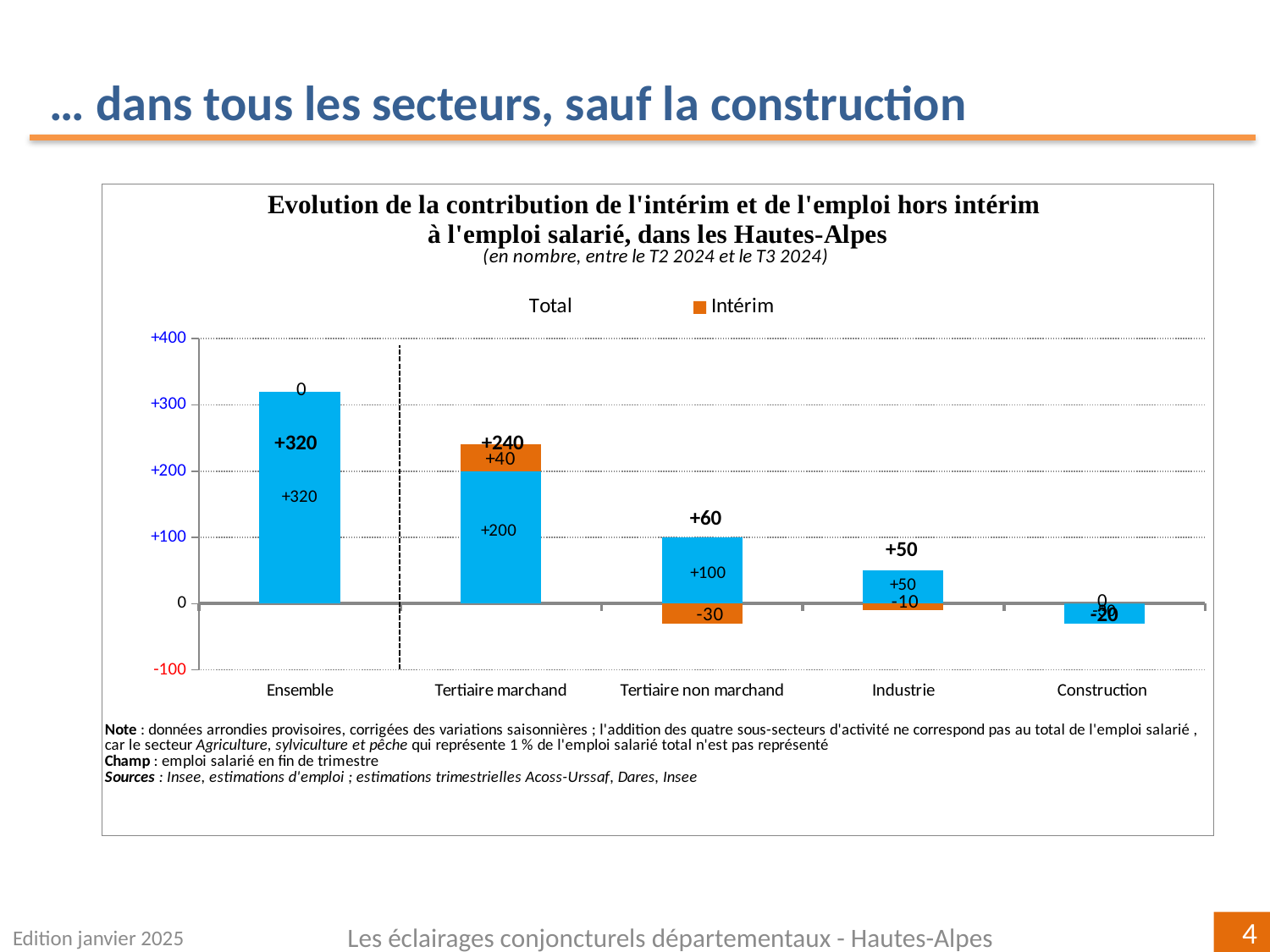
Is the total value for Ensemble greater or less than +300? greater What is the total value shown for Industrie? +50 What is the Intérim value for Tertiaire non marchand? -30 How many sector categories are shown on the x axis? 5 What is the total value shown for Tertiaire marchand? +240 What is the difference between the total for Ensemble (+320) and the total for Tertiaire marchand (+240)? 80 How many series does the legend list? 2 What kind of chart is shown on the slide? Stacked bar chart Which category has the highest total value? Ensemble What is the Intérim value for Tertiaire marchand? +40 Which category has the lowest total value? Construction Which is larger, the total for Tertiaire non marchand or the total for Industrie? Tertiaire non marchand